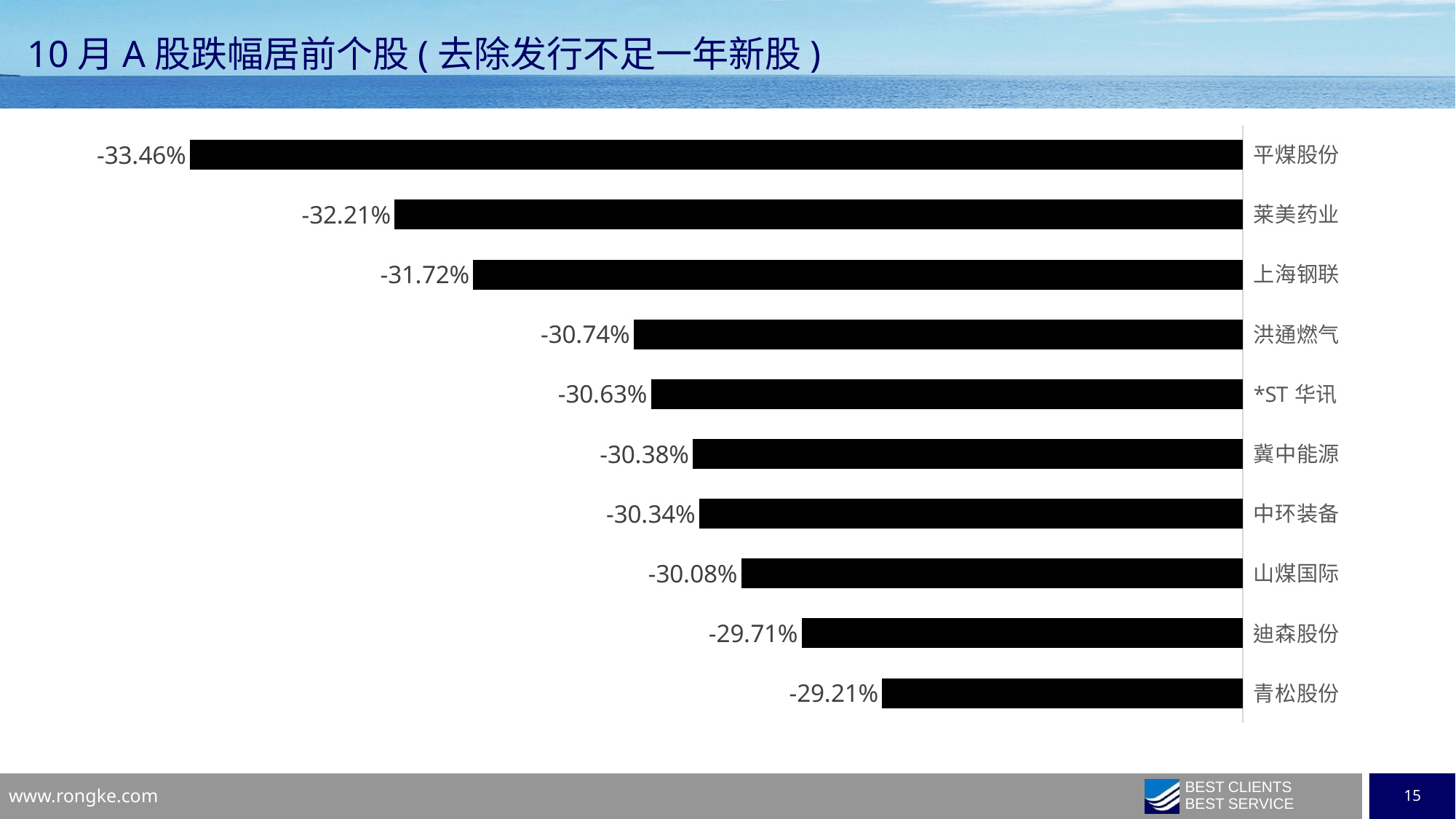
What is the difference in percentage points between the values for 平煤股份 and 青松股份? 4.25 percentage points What is the value shown for *ST 华讯? -30.63% What is the value shown for 洪通燃气? -30.74% What is the value shown for 青松股份? -29.21% Which stock has the largest decline (the lowest value) on the chart? 平煤股份 What kind of chart is shown on the slide? Bar chart Which stock has the smallest decline (the highest value) on the chart? 青松股份 How many stocks are shown on the chart? 10 What is the value shown for 平煤股份? -33.46% Which stock fell more in October, 冀中能源 or 山煤国际? 冀中能源 What is the title of the slide? 10月A股跌幅居前个股(去除发行不足一年新股) What is the difference in percentage points between the values for 莱美药业 and 上海钢联? 0.49 percentage points